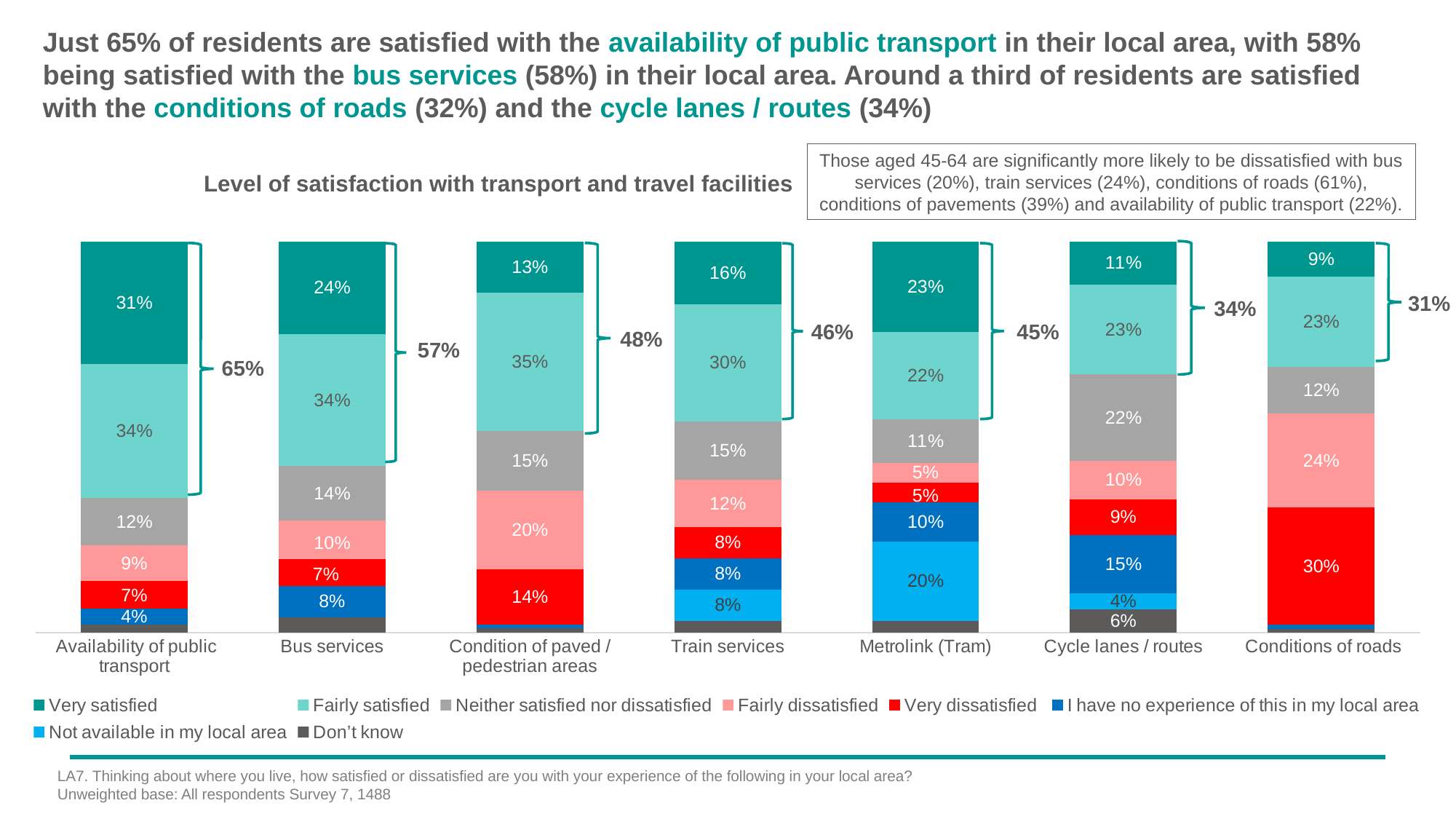
Which has a larger 'Very satisfied' percentage: bus services or train services? Bus services How many series does the chart's legend list? 8 Which facility has the lowest combined satisfied percentage shown by the brackets? Conditions of roads How many transport and travel facilities (categories) are shown on the x axis of the chart? 7 What percentage of residents say Metrolink (Tram) is not available in their local area? 20% What is the difference between the 'Fairly satisfied' percentage for condition of paved / pedestrian areas and for cycle lanes / routes? 12% What percentage of residents are very dissatisfied with the conditions of roads? 30% What is the combined satisfied percentage shown by the bracket for train services? 46% Which facility has the highest 'Very dissatisfied' percentage? Conditions of roads What is the title of the chart? Level of satisfaction with transport and travel facilities What percentage of residents are very satisfied with the availability of public transport? 31% What kind of chart is shown on the slide? Stacked bar chart